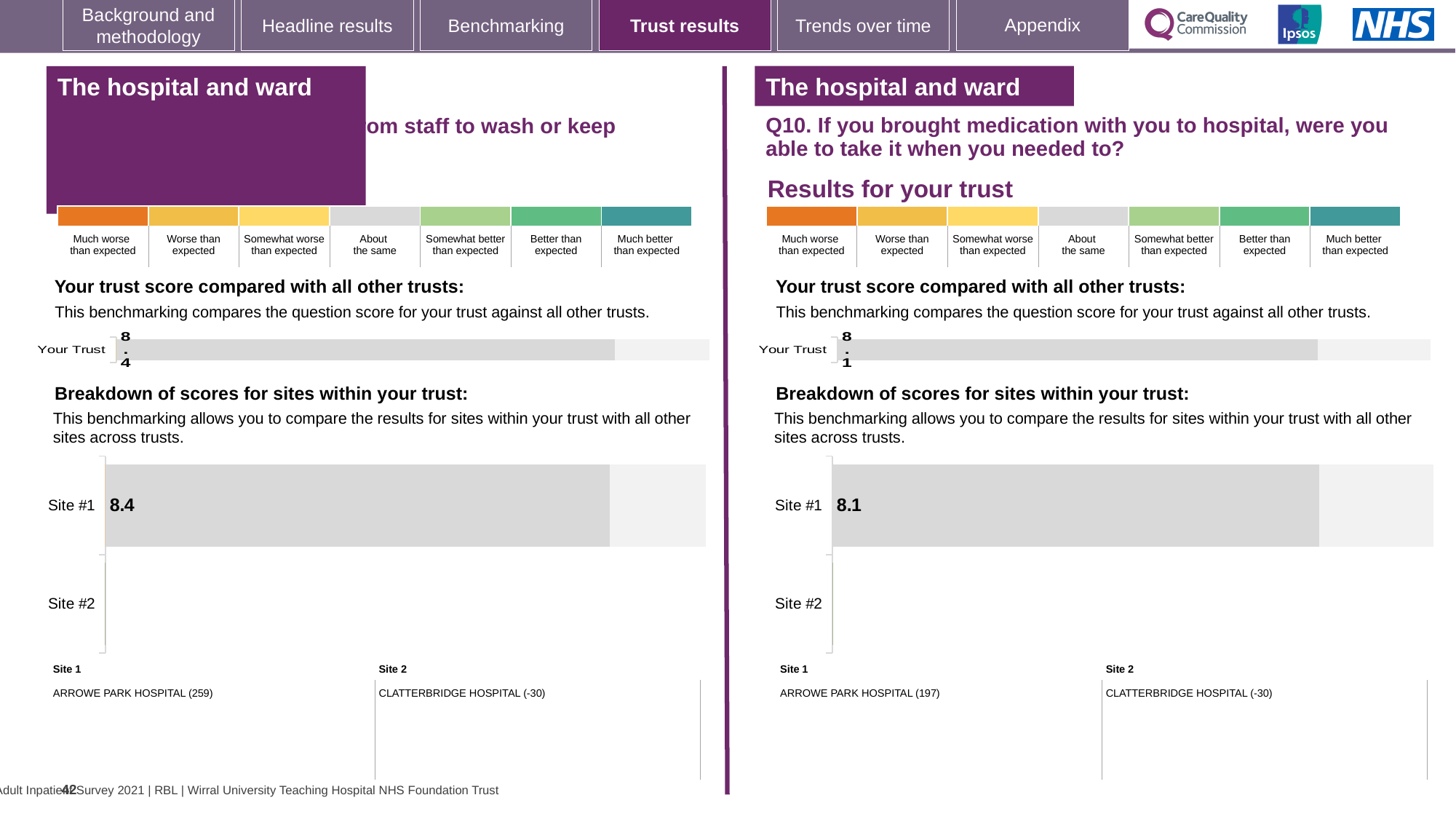
What kind of chart is used for the 'Your trust score compared with all other trusts' section on the right-hand side? Bar chart On the left-hand 'Your trust score compared with all other trusts' chart, what is the score shown for Your Trust? 8.4 On the right-hand site breakdown chart (Q10), which site has a score bar shown? Site #1 Which site name is listed as Site 1 beneath the right-hand site breakdown chart (Q10)? ARROWE PARK HOSPITAL (197) How many sites are listed on the left-hand 'Breakdown of scores for sites within your trust' chart? 2 Which is larger: the Site #1 score on the left-hand site breakdown chart or the Site #1 score on the right-hand site breakdown chart (Q10)? Left-hand chart (8.4) How many sites are listed on the right-hand 'Breakdown of scores for sites within your trust' chart (Q10)? 2 On the left-hand 'Breakdown of scores for sites within your trust' chart, what is the score for Site #1? 8.4 On the right-hand 'Breakdown of scores for sites within your trust' chart (Q10), what is the score for Site #1? 8.1 What is the difference between the Your Trust score on the left-hand chart and the Your Trust score on the right-hand chart (Q10)? 0.3 On the right-hand 'Your trust score compared with all other trusts' chart (Q10), what is the score shown for Your Trust? 8.1